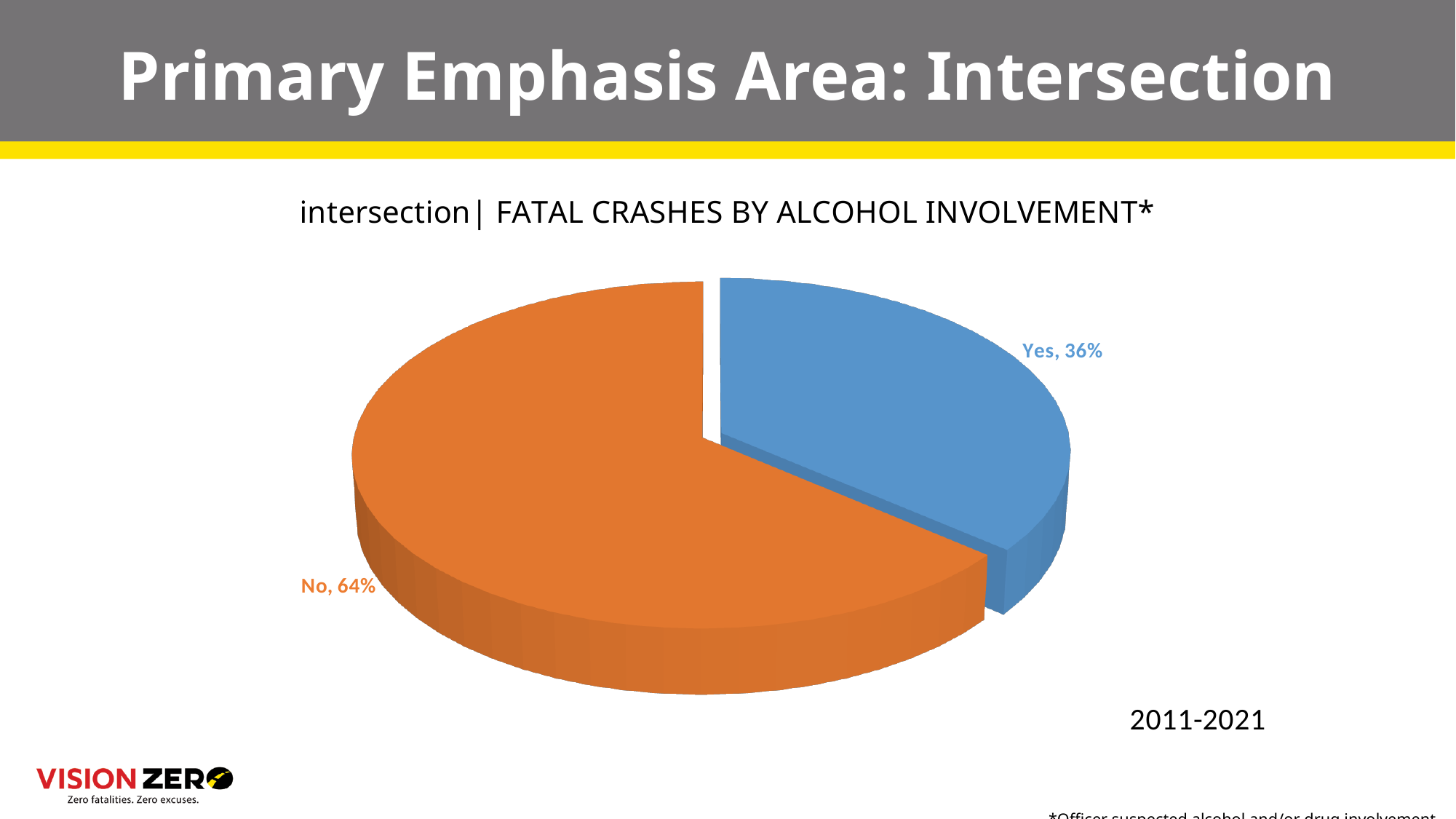
Which category has the smallest slice of the pie? Yes Is the share for Yes greater or less than 50%? less What colour is the Yes slice of the pie? Blue Which category has the larger share of the pie, Yes or No? No What kind of chart is shown on the slide? Pie chart Which category has the largest slice of the pie? No What share of intersection fatal crashes involved alcohol (Yes)? 36% What is the difference in percentage points between the No and Yes slices? 28 What is the title of the chart? intersection| FATAL CRASHES BY ALCOHOL INVOLVEMENT* What year range does the chart cover? 2011-2021 How many slices does the pie chart have? 2 What share of intersection fatal crashes did not involve alcohol (No)? 64%